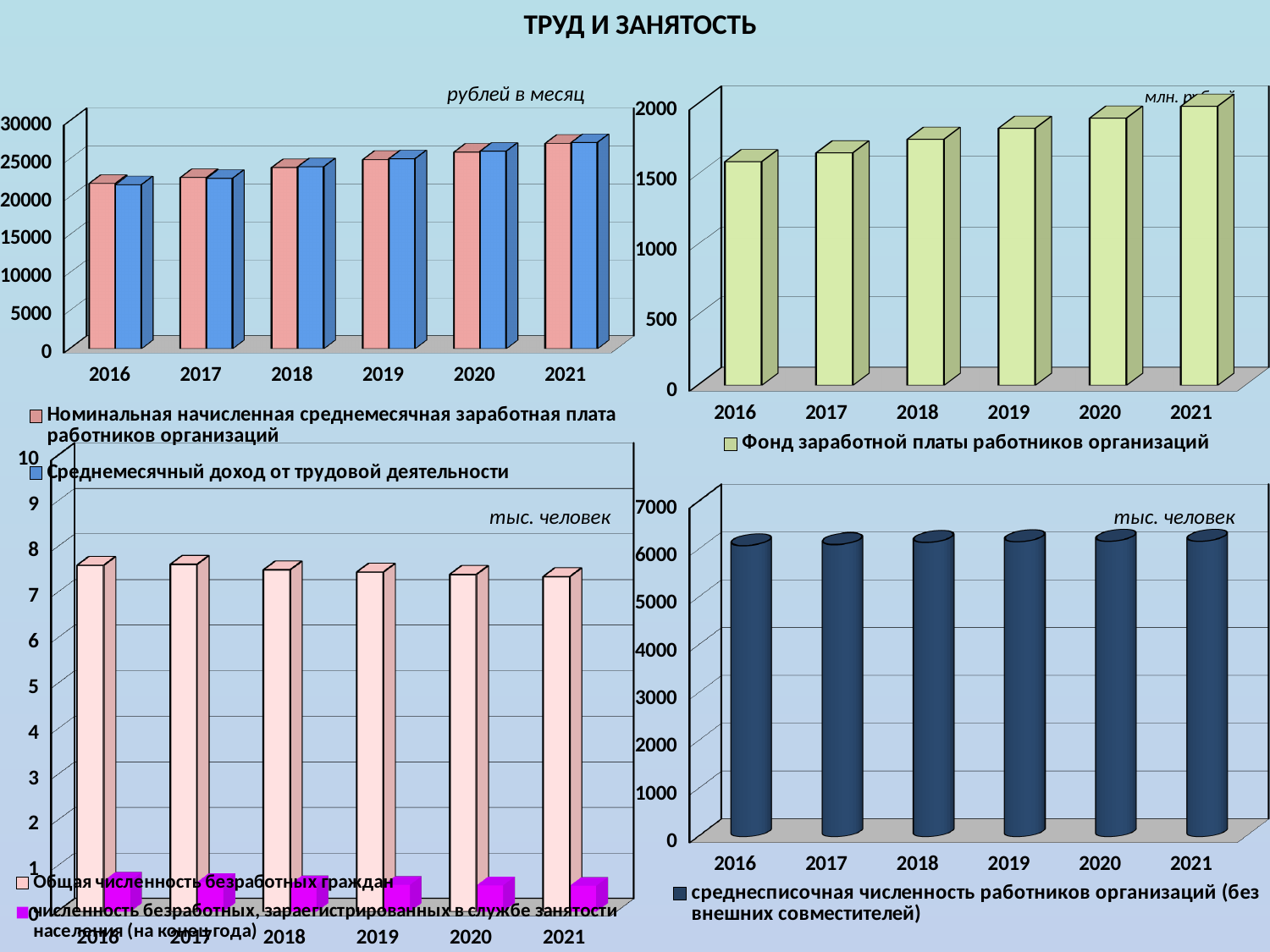
On the top-left chart (рублей в месяц), how many years are shown on the x axis? 6 On the bottom-left chart (тыс. человек, unemployment), is the value for Численность безработных, зарегистрированных в службе занятости населения in 2021 greater or less than 1? less On the top-right chart (Фонд заработной платы работников организаций), is the value for 2016 greater or less than 1500? greater What kind of chart is the top-right chart (Фонд заработной платы работников организаций)? bar chart On the top-left chart (рублей в месяц), do the values for Номинальная начисленная среднемесячная заработная плата работников организаций rise or fall from 2016 to 2021? rise On the bottom-left chart (тыс. человек, unemployment), is the value for Общая численность безработных граждан in 2016 greater or less than 7? greater On the top-left chart (рублей в месяц), which year has the highest value for Среднемесячный доход от трудовой деятельности? 2021 On the top-left chart (рублей в месяц), how many series does the legend list? 2 On the top-right chart (Фонд заработной платы работников организаций), which year has the lowest value? 2016 On the bottom-left chart (тыс. человек, unemployment), which series is larger in 2016: Общая численность безработных граждан or Численность безработных, зарегистрированных в службе занятости населения (на конец года)? Общая численность безработных граждан